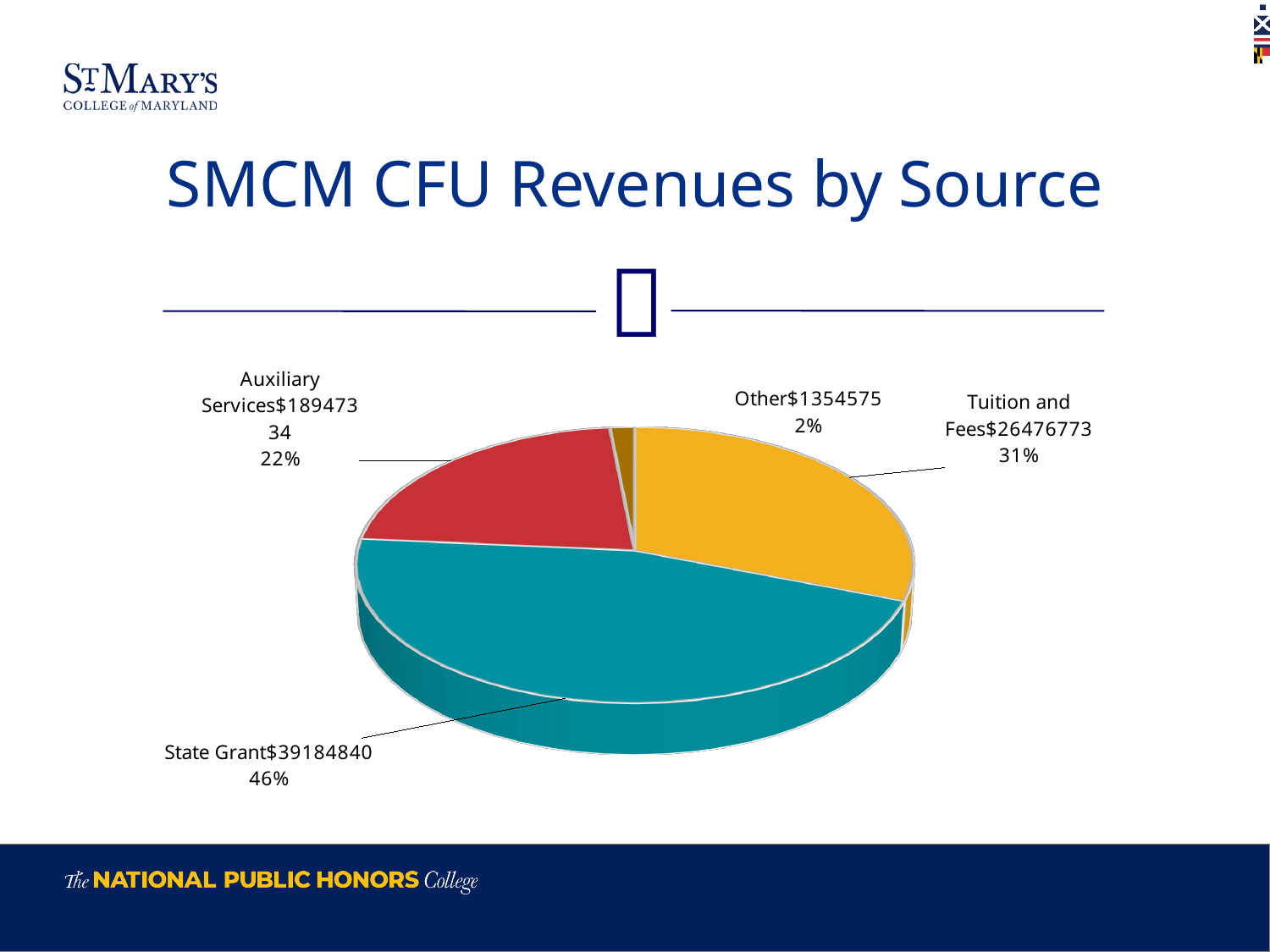
Which revenue source has the largest share of the pie? State Grant What is the revenue value shown for Other? $1354575 What share of the pie does Auxiliary Services represent? 22% What is the revenue value shown for State Grant? $39184840 What is the revenue value shown for Tuition and Fees? $26476773 Which revenue source has the smallest share of the pie? Other What is the title of the chart? SMCM CFU Revenues by Source What type of chart is shown on the slide? pie chart What share of the pie does Tuition and Fees represent? 31% What share of the pie does Other represent? 2% How many slices does the pie chart have? 4